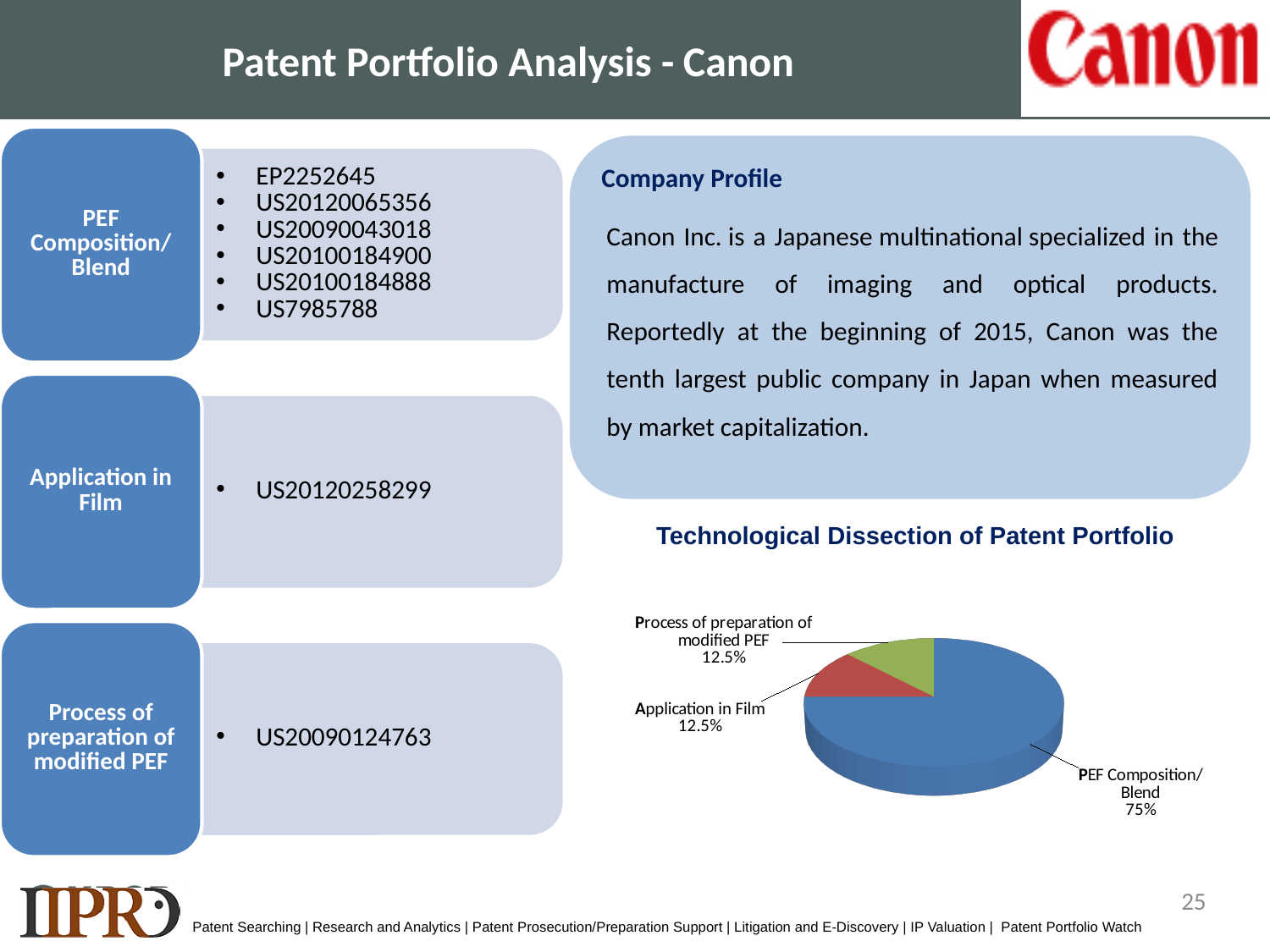
What share of the pie chart does 'PEF Composition/Blend' represent? 75% Which category has the largest slice in the pie chart? PEF Composition/Blend What is the difference in percentage points between the 'PEF Composition/Blend' slice and the 'Application in Film' slice? 62.5 What share of the pie chart does 'Application in Film' represent? 12.5% Is the share for 'PEF Composition/Blend' greater or less than 50%? greater Which is larger in the pie chart: 'PEF Composition/Blend' or 'Process of preparation of modified PEF'? PEF Composition/Blend What is the title of the pie chart? Technological Dissection of Patent Portfolio What is the combined share of 'Application in Film' and 'Process of preparation of modified PEF' in the pie chart? 25% What share of the pie chart does 'Process of preparation of modified PEF' represent? 12.5% What type of chart is shown under 'Technological Dissection of Patent Portfolio'? Pie chart What colour is the 'PEF Composition/Blend' slice in the pie chart? Blue How many slices does the pie chart have? 3